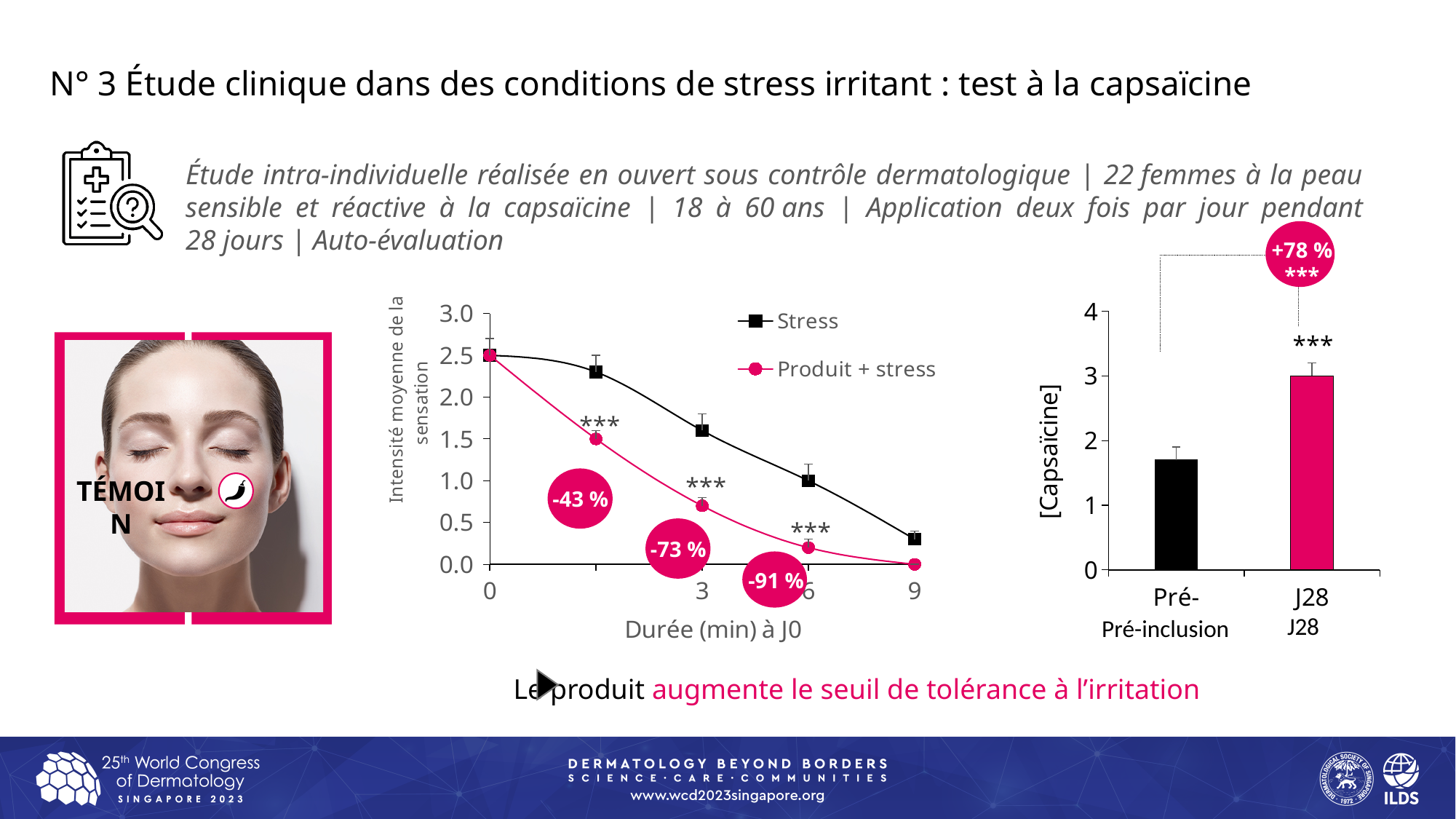
What kind of chart is the chart on the left with the x axis 'Durée (min) à J0'? line chart In the bar chart on the right, which category has the higher value? J28 What kind of chart is the chart on the right with the y axis '[Capsaïcine]'? bar chart In the line chart on the left, how many series does the legend list? 2 In the line chart on the left, what percentage reduction is labelled at 6 minutes? -91 % In the bar chart on the right, is the value for Pré-inclusion greater or less than 2? less In the bar chart on the right, what percentage change is labelled between Pré-inclusion and J28? +78 % In the line chart on the left, at 3 minutes, which series has the higher value: Stress or Produit + stress? Stress In the line chart on the left, what is the first (smallest) percentage reduction label shown? -43 % In the line chart on the left, does the Stress series rise or fall as duration increases? fall In the line chart on the left, what are the two legend entries? Stress; Produit + stress In the line chart on the left, what percentage reduction is labelled at 3 minutes? -73 %